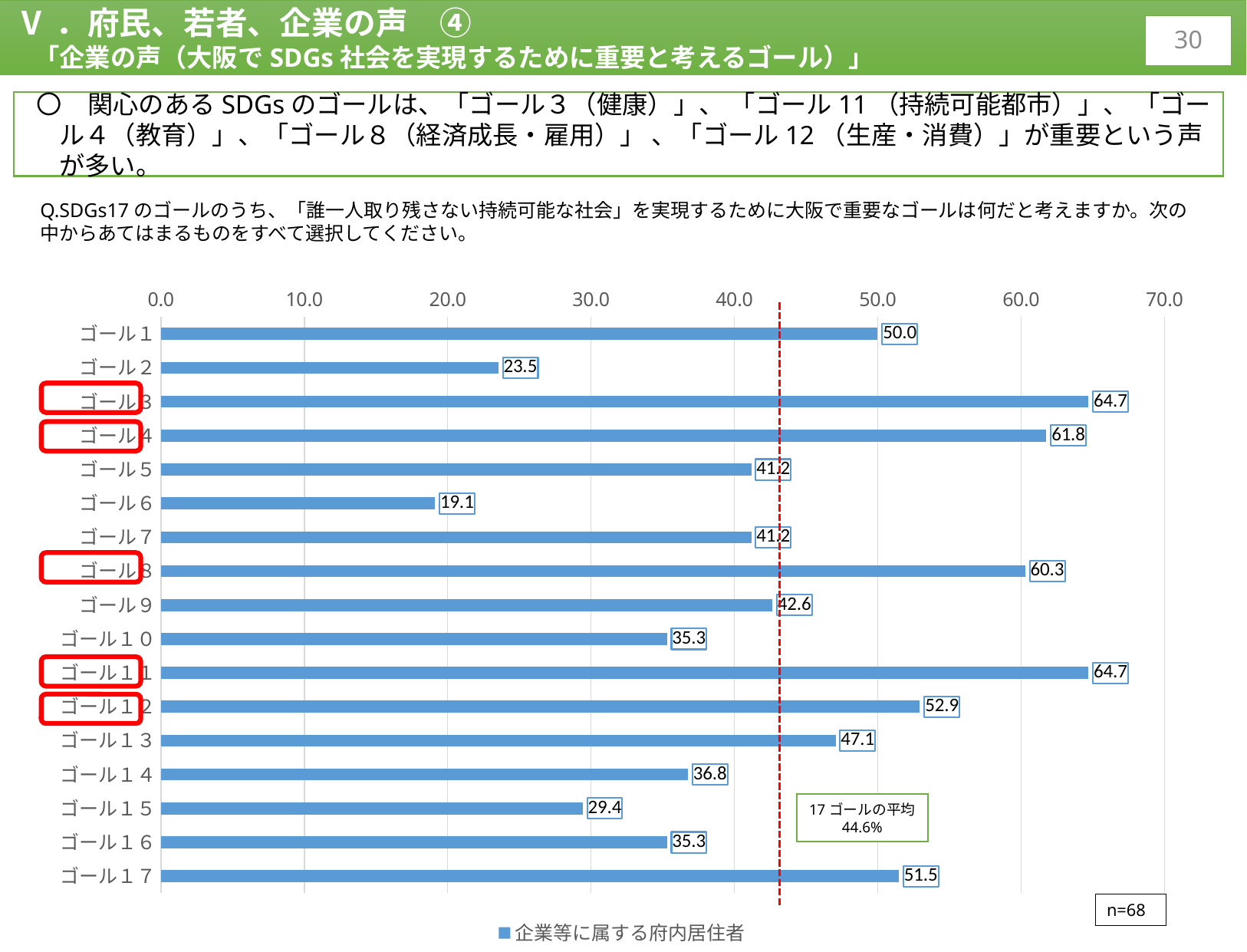
What average value for the 17 goals is noted on the chart? 44.6% What is the value for ゴール１２? 52.9 Which goal has the lowest value? ゴール６ What is the value for ゴール３? 64.7 How many goals (categories) are plotted in the chart? 17 What kind of chart is shown on the slide? bar chart Which is larger, the value for ゴール１３ or the value for ゴール１４? ゴール１３ What is the value for ゴール６? 19.1 What is the difference between the values for ゴール１ and ゴール２? 26.5 What is the difference between the values for ゴール４ and ゴール８? 1.5 Is the value for ゴール１５ greater or less than 30.0? less What is the value for ゴール１７? 51.5